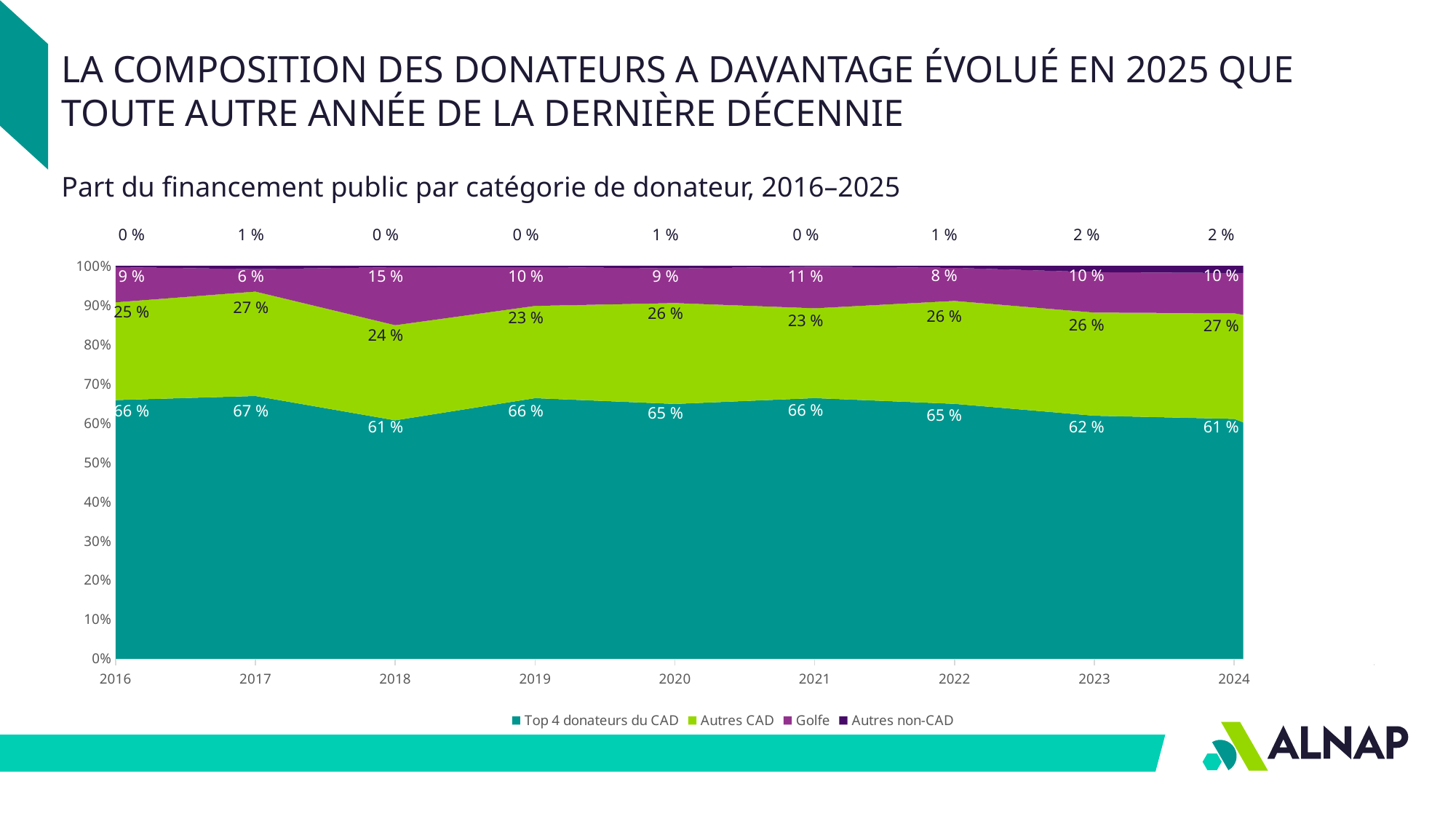
What kind of chart is shown? Stacked area chart What share did Top 4 donateurs du CAD have in 2017? 67 % Which series is shown in purple in the legend? Golfe In which year was the Golfe share highest? 2018 How many series does the legend list? 4 How many years are shown on the x axis? 9 What is the difference between the Top 4 donateurs du CAD share in 2017 and in 2024? 6 % What share did Golfe have in 2018? 15 % What share did Autres CAD have in 2024? 27 % Which was larger in 2021: the Autres CAD share or the Golfe share? Autres CAD What share did Autres non-CAD have in 2023? 2 % In which year was the Golfe share lowest? 2017